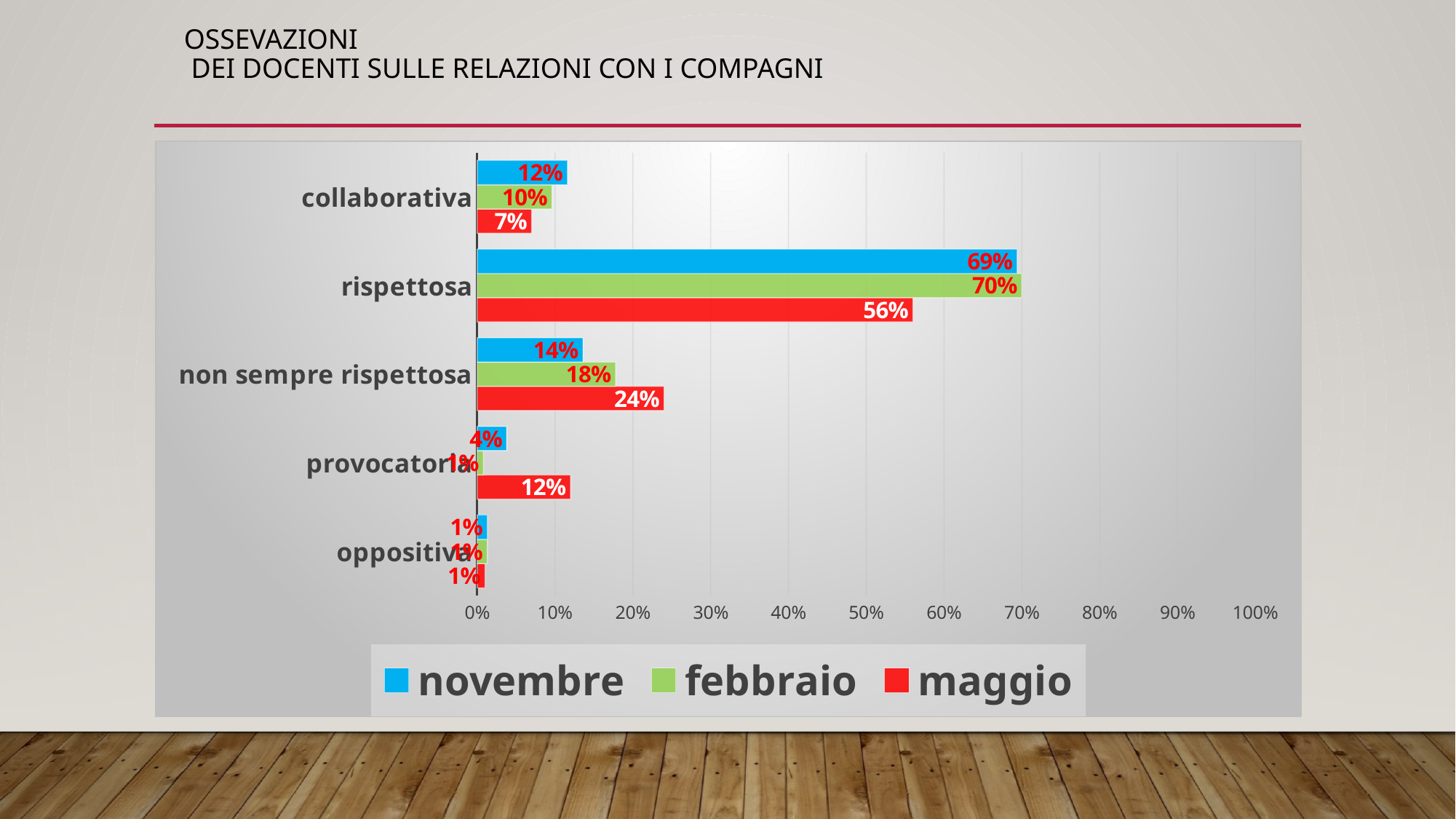
Which category has the highest value in the 'novembre' series? rispettosa Which is larger for 'non sempre rispettosa': the 'novembre' value or the 'maggio' value? maggio Which colour represents the 'febbraio' series in the legend? green Which category has the lowest value in the 'maggio' series? oppositiva How many series does the legend list? 3 What is the difference between the 'febbraio' and 'maggio' values for 'rispettosa'? 14% What is the value for 'rispettosa' in the 'maggio' series? 56% Is the 'novembre' value for 'rispettosa' greater or less than 60%? greater What kind of chart is shown on the slide? bar chart How many categories are shown on the chart? 5 What is the value for 'non sempre rispettosa' in the 'febbraio' series? 18% What is the value for 'provocatoria' in the 'maggio' series? 12%